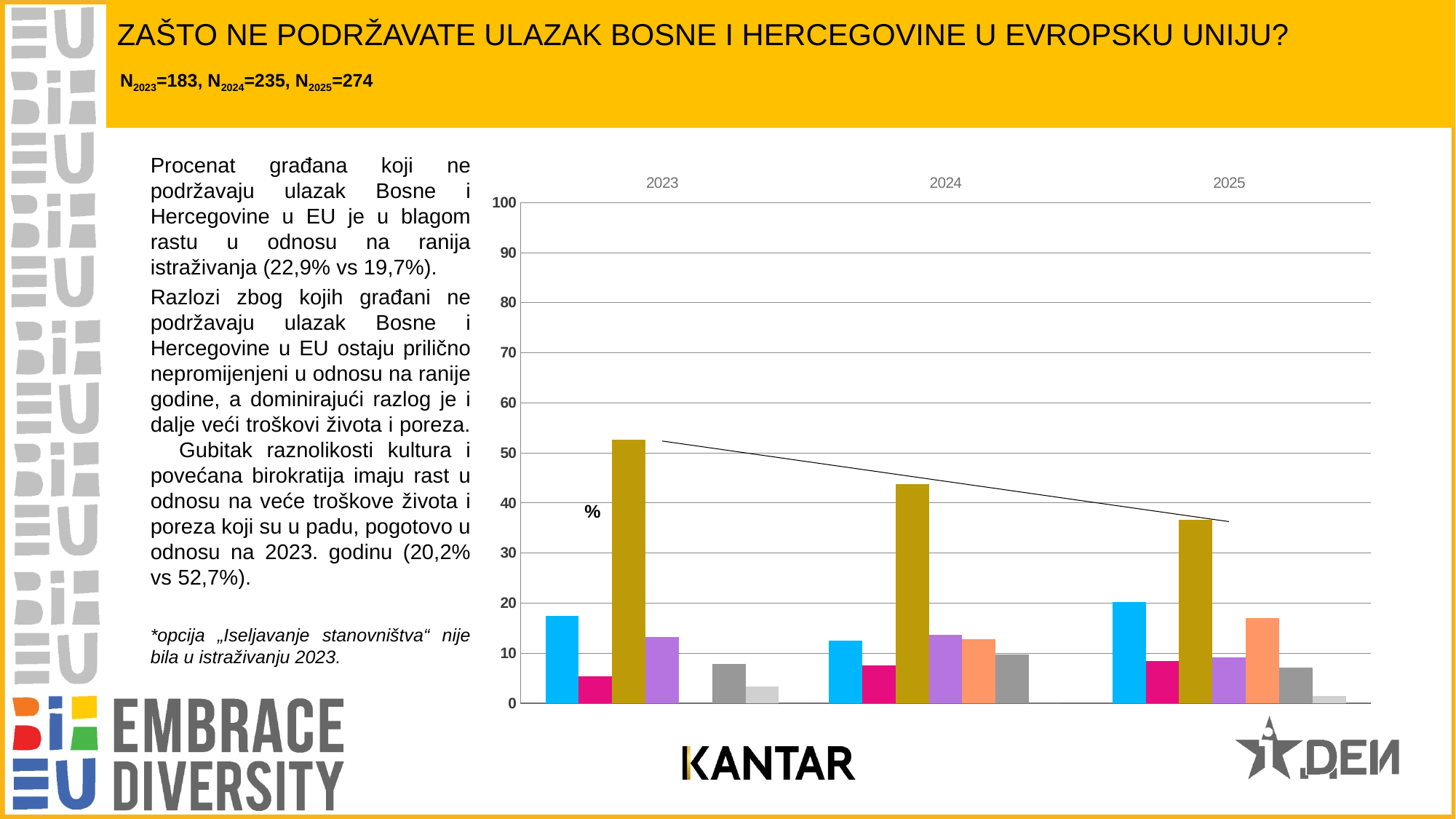
How many bars are plotted in the 2025 group? 7 Is the value of the gold bar for 2025 greater or less than 40? less How many year categories are shown on the x axis of the chart? 3 Is the value of the light blue bar for 2023 greater or less than 20? less Is the value of the gold bar for 2025 greater or less than 30? greater Does the gold bar rise or fall from 2023 to 2025? fall What is the highest value shown on the vertical axis of the chart? 100 Which is larger, the gold bar for 2023 or the gold bar for 2025? the gold bar for 2023 What kind of chart is shown on the slide? bar chart Which year's group contains the tallest bar in the chart? 2023